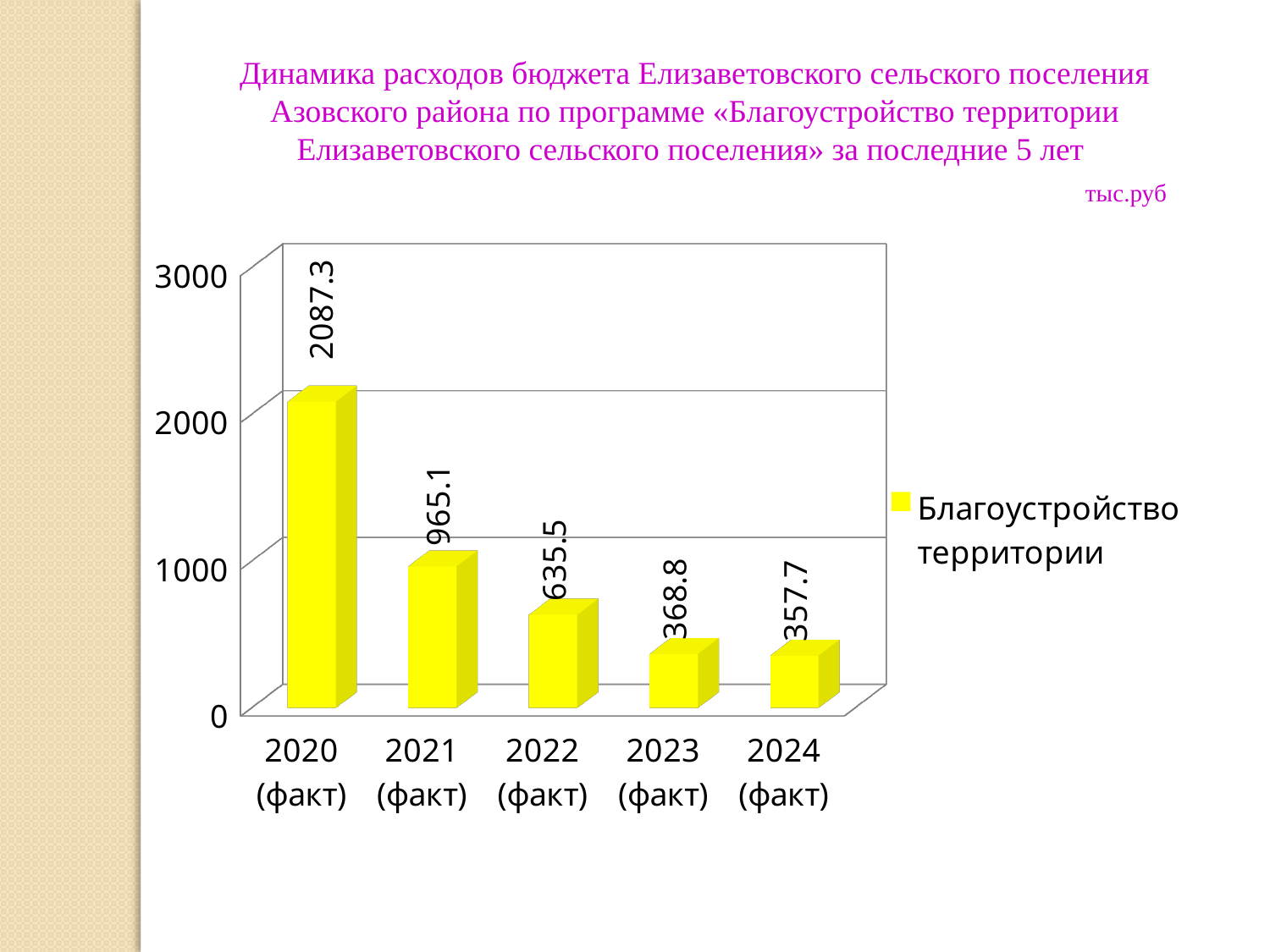
Which year has the highest value? 2020 (факт) Which is larger, the value for 2021 (факт) or the value for 2022 (факт)? 2021 (факт) How many years are shown on the x axis? 5 What is the value for 2024 (факт)? 357.7 What is the value for 2020 (факт)? 2087.3 Is the value for 2020 (факт) greater or less than 2000? greater Which year has the lowest value? 2024 (факт) What is the difference between the values for 2023 (факт) and 2024 (факт)? 11.1 What kind of chart is shown on the slide? bar chart What is the value for 2022 (факт)? 635.5 Do the values rise or fall from 2020 to 2024? fall What is the difference between the values for 2020 (факт) and 2021 (факт)? 1122.2